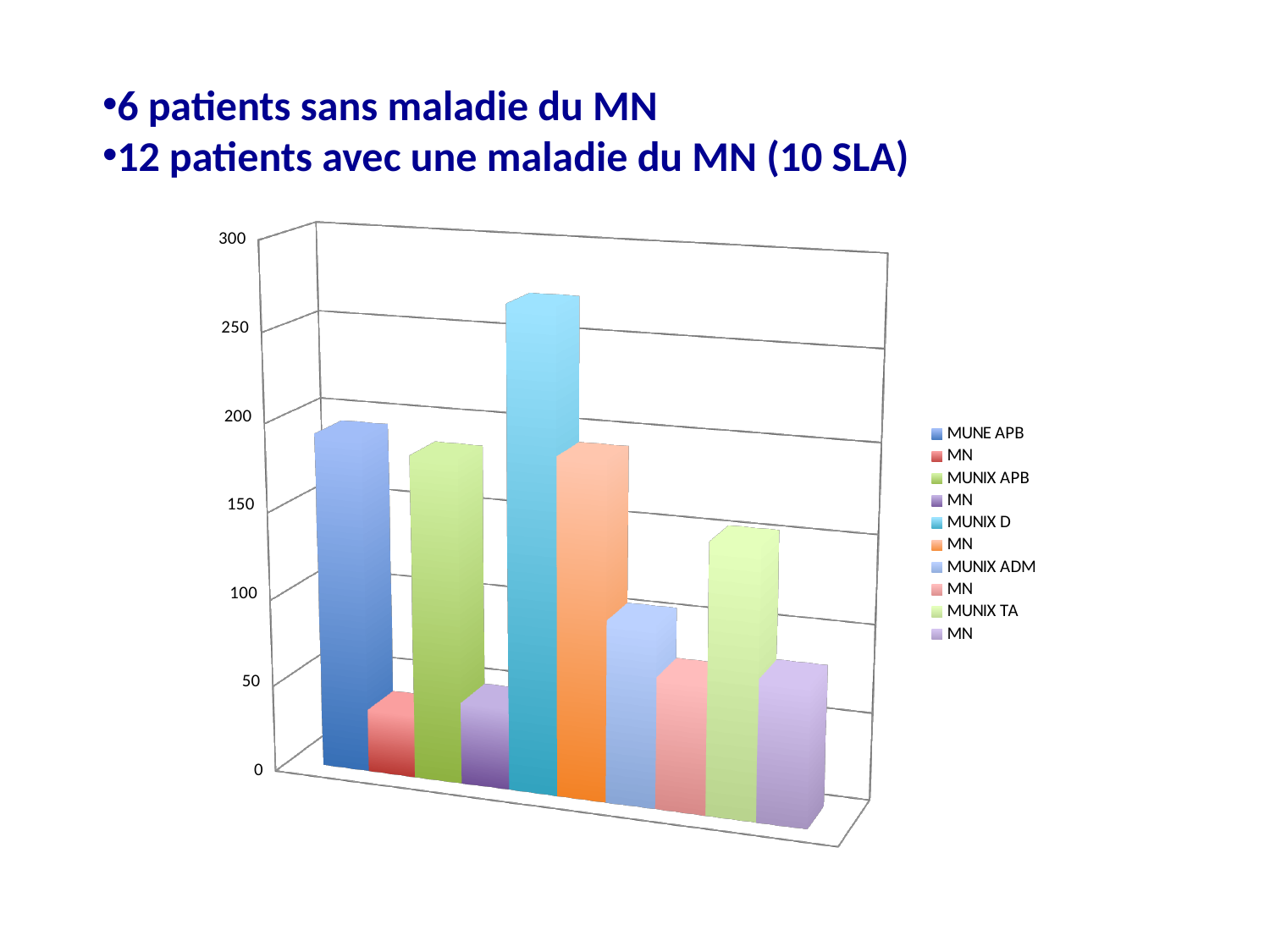
Is the value for MUNIX ADM greater or less than 150? less How many bars are plotted in the chart? 10 What kind of chart is shown on the slide? bar chart Which is larger, the bar for MUNIX APB or the bar for MUNIX TA? MUNIX APB Is the value for MUNIX TA greater or less than 100? greater Is the value for MUNIX D greater or less than 200? greater Which is larger, the bar for MUNIX D or the bar for MUNE APB? MUNIX D Which is larger, the bar for MUNIX ADM or the bar for MUNIX TA? MUNIX TA How many entries does the chart legend list? 10 Which legend entry has the tallest bar in the chart? MUNIX D What is the highest value shown on the vertical axis of the chart? 300